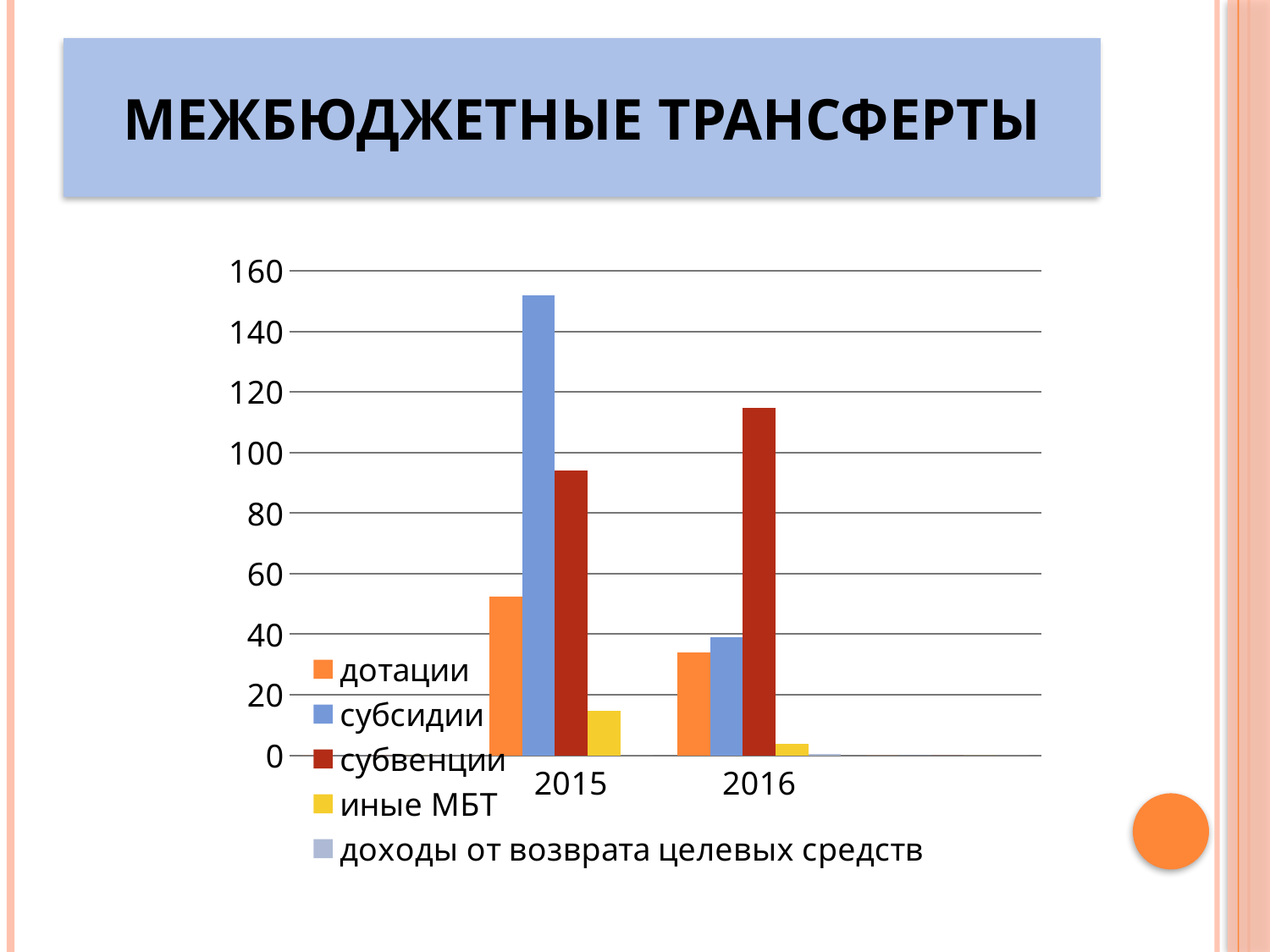
Is the value for дотации in 2015 greater or less than 60? less How many series does the legend list? 5 Is the value for субсидии in 2015 greater or less than 140? greater Do the values for субсидии rise or fall from 2015 to 2016? fall What kind of chart is shown on the slide? bar chart How many categories are shown on the x axis? 2 Is the value for субвенции in 2016 greater or less than 100? greater What is the title of the slide containing the chart? МЕЖБЮДЖЕТНЫЕ ТРАНСФЕРТЫ Which series has the highest value in 2016? субвенции Which is larger: субвенции in 2015 or субвенции in 2016? субвенции in 2016 Which series has the highest value in 2015? субсидии